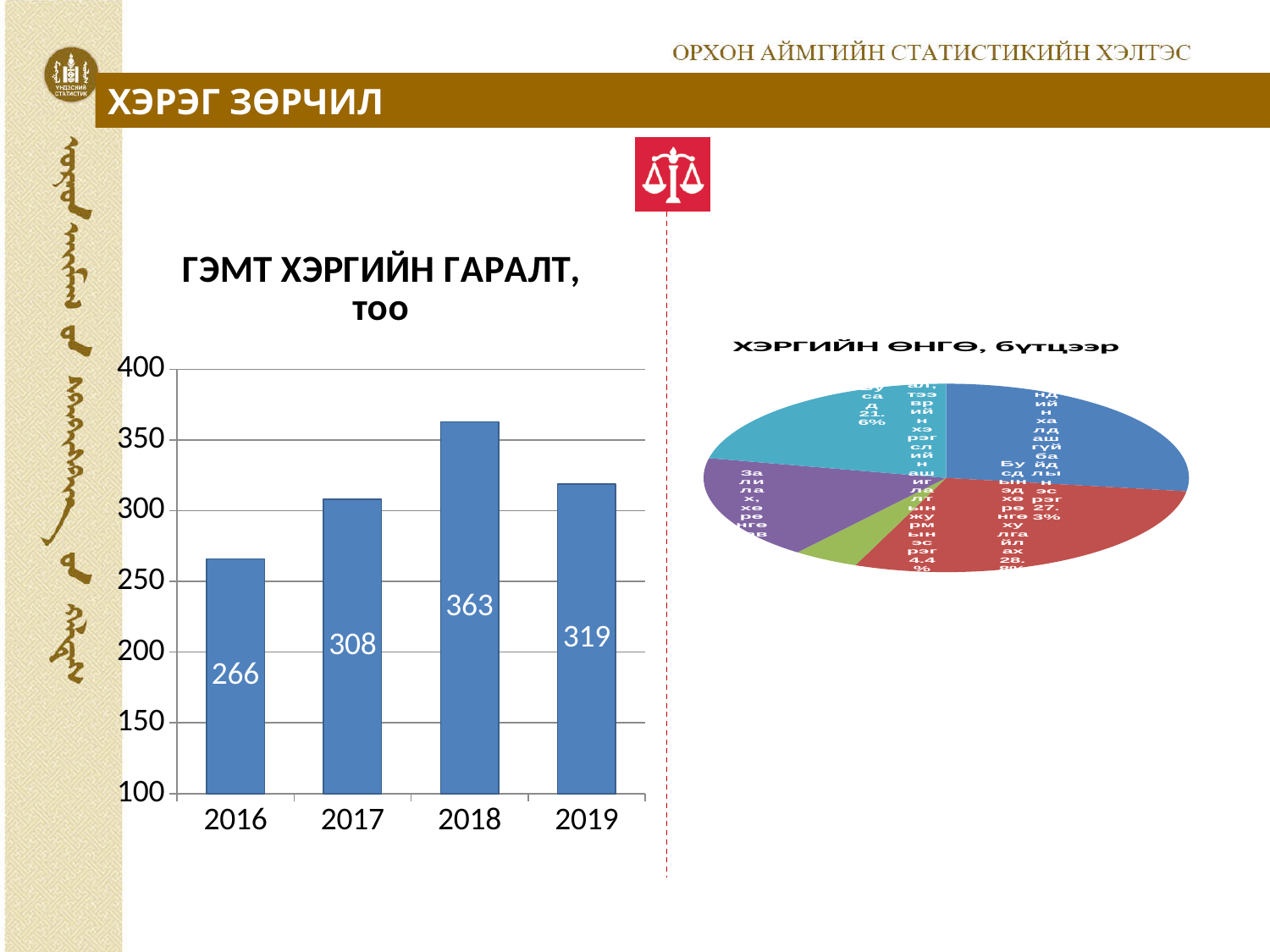
How many years are shown in the bar chart titled 'ГЭМТ ХЭРГИЙН ГАРАЛТ, тоо'? 4 In the bar chart titled 'ГЭМТ ХЭРГИЙН ГАРАЛТ, тоо', which is larger, the value for 2017 or the value for 2019? 2019 What kind of chart is the chart on the left titled 'ГЭМТ ХЭРГИЙН ГАРАЛТ, тоо'? bar chart In the bar chart titled 'ГЭМТ ХЭРГИЙН ГАРАЛТ, тоо', which year has the highest value? 2018 In the bar chart titled 'ГЭМТ ХЭРГИЙН ГАРАЛТ, тоо', what is the value for 2018? 363 In the bar chart titled 'ГЭМТ ХЭРГИЙН ГАРАЛТ, тоо', which year has the lowest value? 2016 In the bar chart titled 'ГЭМТ ХЭРГИЙН ГАРАЛТ, тоо', do the values rise or fall from 2016 to 2018? rise In the bar chart titled 'ГЭМТ ХЭРГИЙН ГАРАЛТ, тоо', what is the value for 2016? 266 In the bar chart titled 'ГЭМТ ХЭРГИЙН ГАРАЛТ, тоо', what is the value for 2019? 319 What kind of chart is the chart on the right titled 'ХЭРГИЙН ӨНГӨ, бүтцээр'? pie chart In the bar chart titled 'ГЭМТ ХЭРГИЙН ГАРАЛТ, тоо', is the value for 2016 greater or less than 300? less In the bar chart titled 'ГЭМТ ХЭРГИЙН ГАРАЛТ, тоо', what is the difference between the values for 2018 and 2017? 55